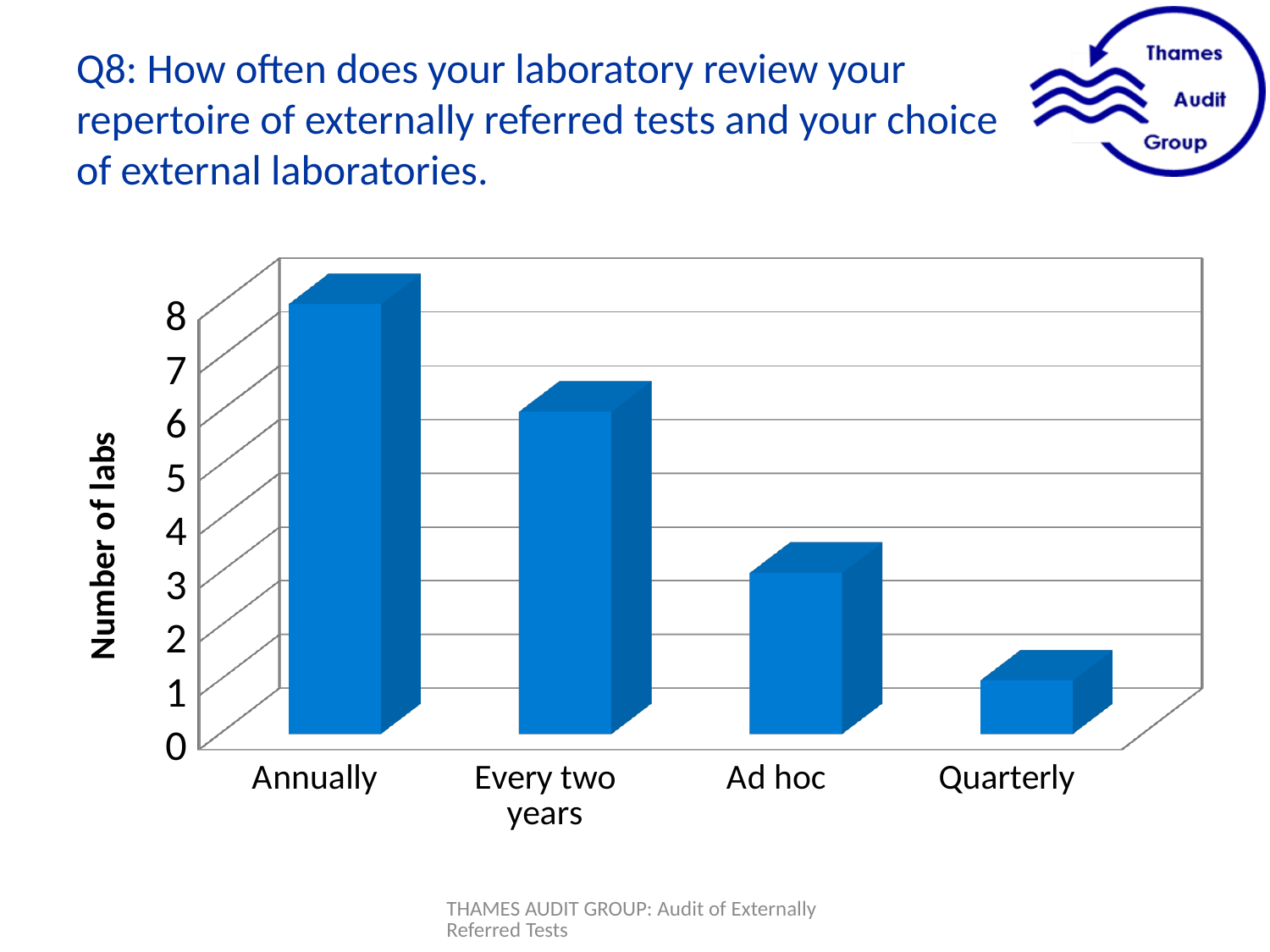
Which has more labs, Every two years or Ad hoc? Every two years Is the value for Every two years greater or less than 5? greater What is the number of labs for Annually? 8 What is the number of labs for Quarterly? 1 Which category has the highest number of labs? Annually Is the value for Ad hoc greater or less than 4? less Which category has the lowest number of labs? Quarterly What is the label of the vertical axis? Number of labs How many categories are shown on the x axis of the chart? 4 What is the number of labs for Ad hoc? 3 What is the number of labs for Every two years? 6 What kind of chart is shown on the slide? bar chart